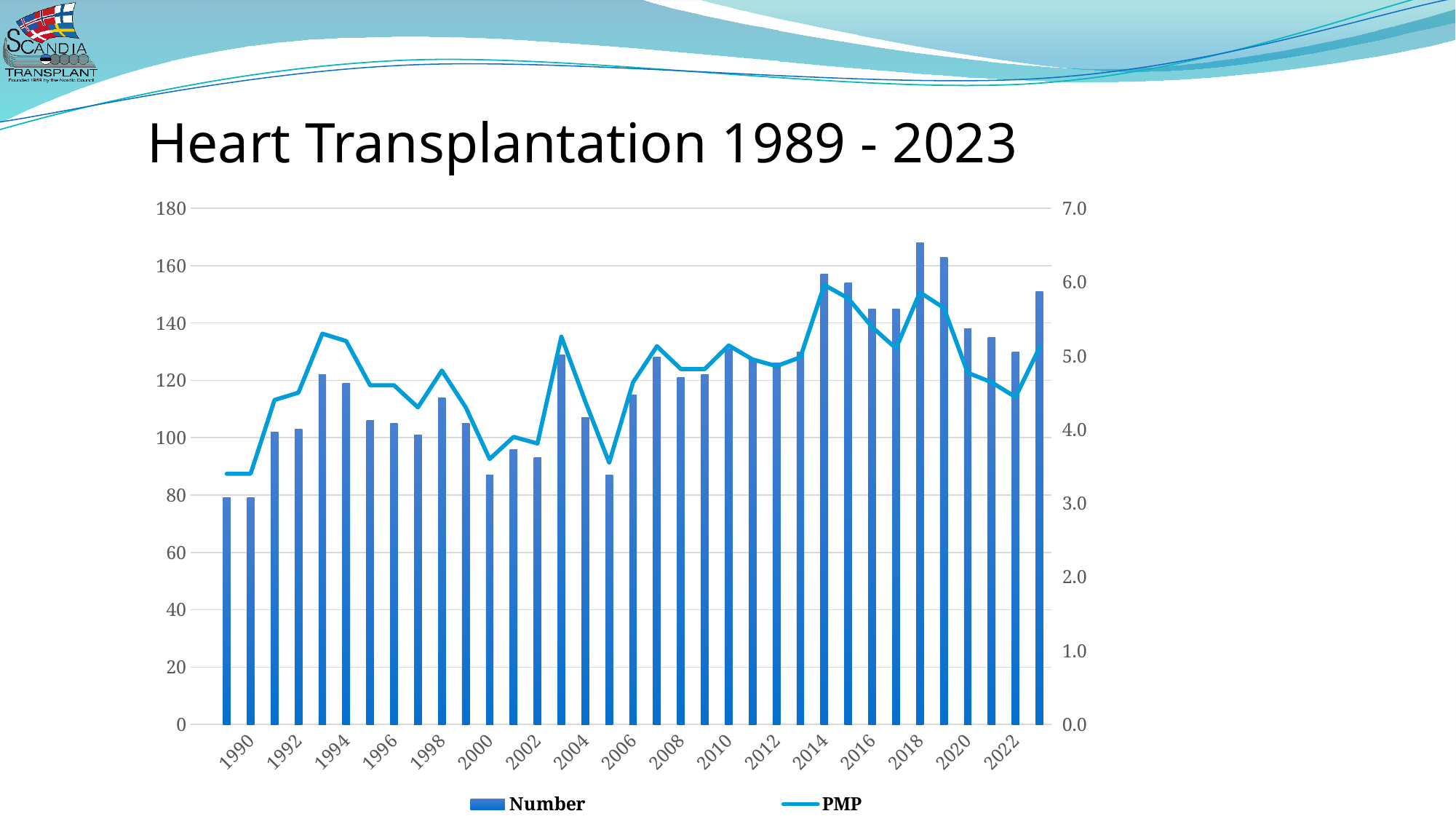
Is the Number value for 2018 greater or less than 160? greater What are the two series named in the legend? Number and PMP Is the PMP value for 1989 greater or less than 4.0? less In which year is the Number bar highest? 2018 Which year has the larger Number value, 2014 or 2016? 2014 What kind of chart is shown on the slide? A combined bar and line chart Is the Number value for 2000 greater or less than 100? less Do the Number bars rise or fall from 2018 to 2022? fall What is the title of the chart? Heart Transplantation 1989 - 2023 How many series does the legend list? 2